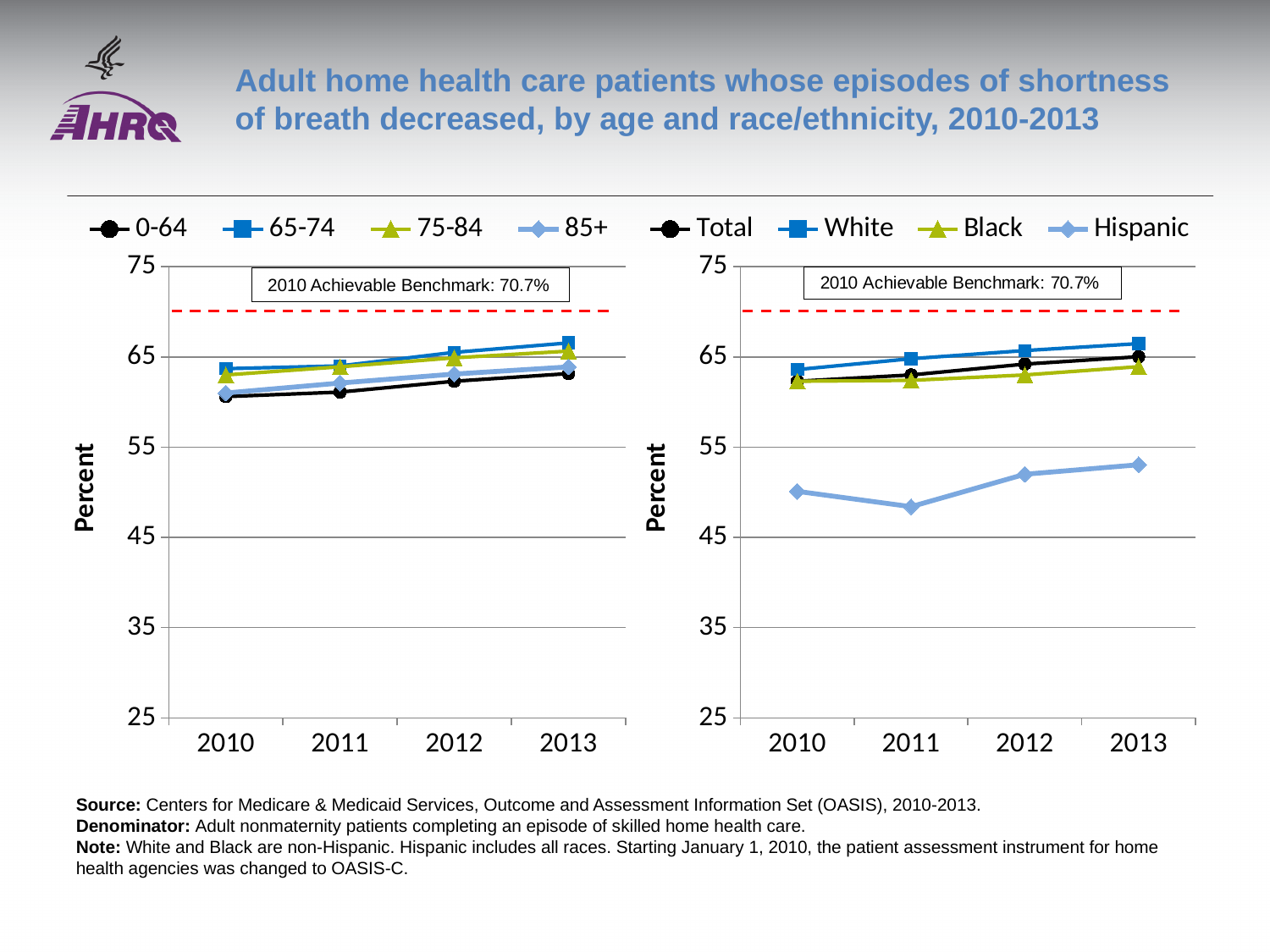
What is the 2010 Achievable Benchmark shown on the charts? 70.7% In the right chart (by race/ethnicity), which is larger in 2013, White or Hispanic? White What kind of chart is the left chart (by age)? line chart In the left chart (by age), is the value for 65-74 in 2013 greater or less than 65? greater In the right chart (by race/ethnicity), is the value for Black in 2013 greater or less than 65? less In the left chart (by age), do the values for 65-74 rise or fall from 2010 to 2013? rise In the right chart (by race/ethnicity), is the value for Hispanic in 2010 greater or less than 55? less In the right chart (by race/ethnicity), which group has the highest value in 2013? White In the right chart (by race/ethnicity), which group has the lowest values across all years? Hispanic How many years are shown on the x axis of the left chart (by age)? 4 How many series does the legend of the right chart (by race/ethnicity) list? 4